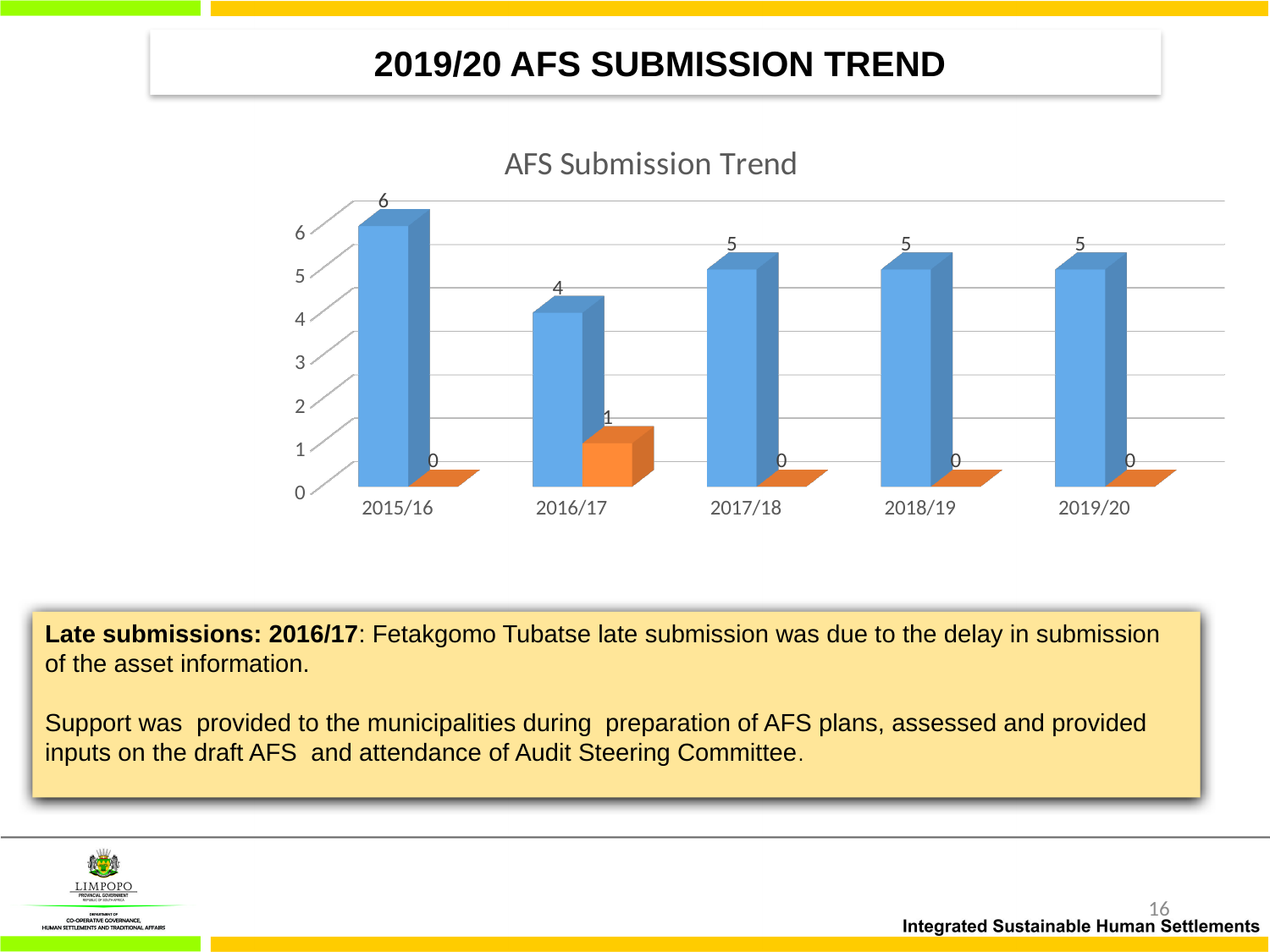
How many years are shown on the x axis? 5 Which year has the lowest blue bar? 2016/17 What is the value of the blue bar for 2015/16? 6 What is the value of the orange bar for 2018/19? 0 What is the value of the blue bar for 2016/17? 4 What is the title of the chart? AFS Submission Trend What kind of chart is shown on the slide? Bar chart Which year has a larger blue bar, 2016/17 or 2017/18? 2017/18 What is the value of the orange bar for 2016/17? 1 Which year has the highest blue bar? 2015/16 What is the value of the blue bar for 2019/20? 5 What is the difference between the blue bar values for 2015/16 and 2016/17? 2